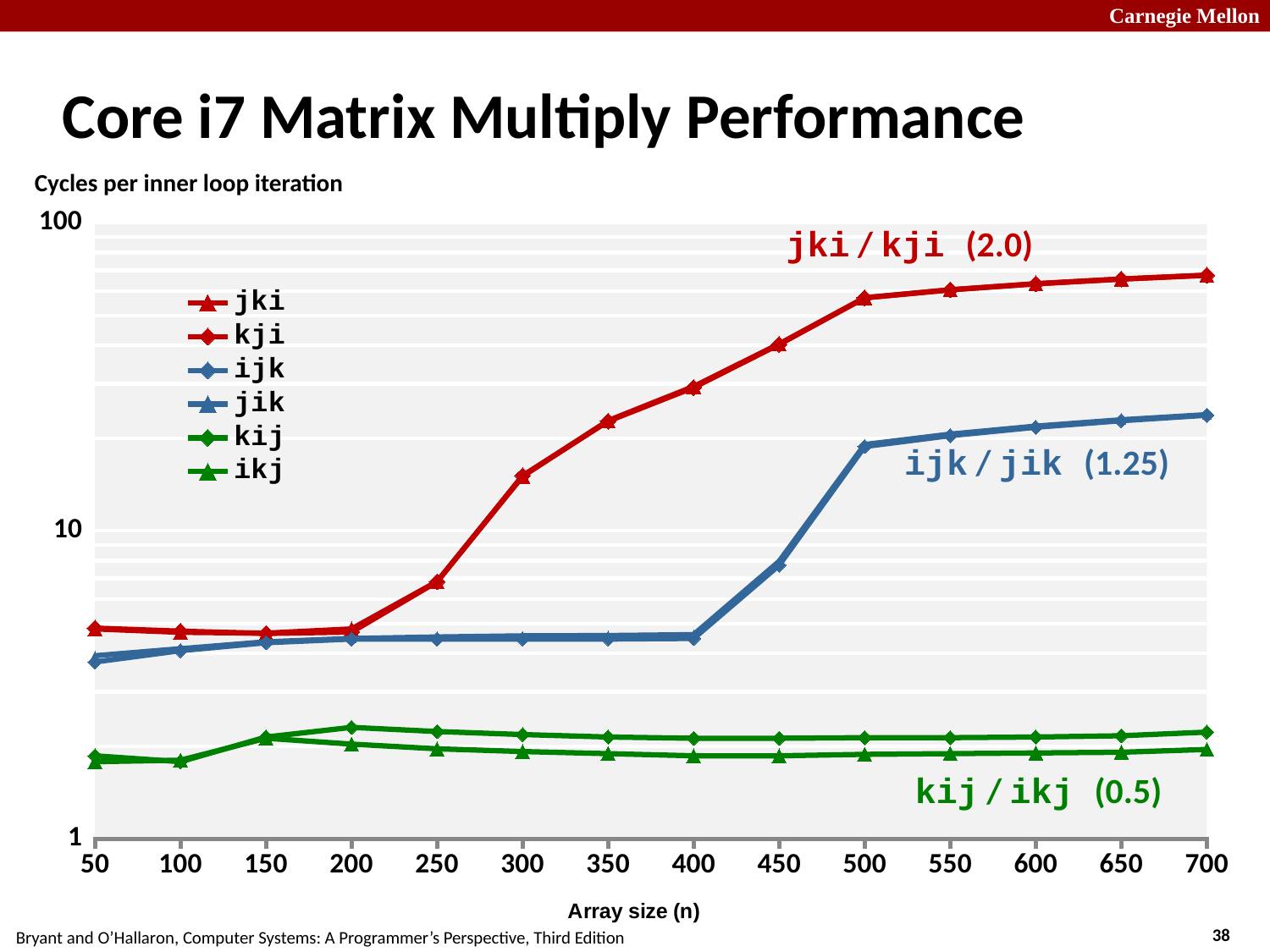
How many series does the legend list? 6 Does the value for jki rise or fall as the array size increases from 200 to 500? rise Is the value for ijk at array size 700 greater or less than 10? greater What is the title of the chart? Core i7 Matrix Multiply Performance How many array size values are marked along the x axis? 14 Is the value for kij at array size 700 greater or less than 10? less What kind of chart is shown on the slide? line chart What is the label of the x axis? Array size (n) At array size 700, which is larger, the value for jki or the value for ijk? jki At array size 300, which is larger, the value for jki or the value for kij? jki Is the value for ijk at array size 400 greater or less than 10? less